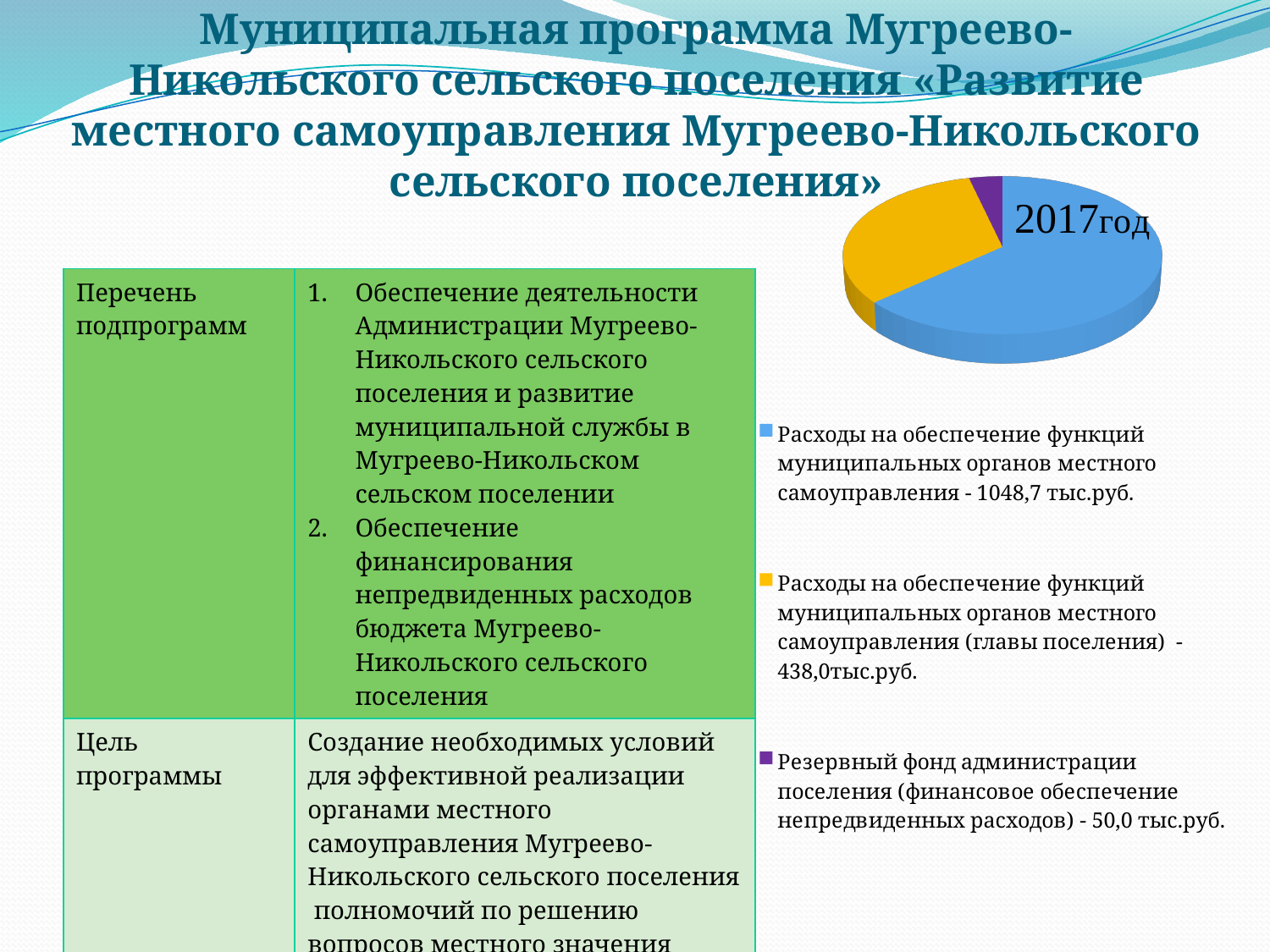
What is the value for «Резервный фонд администрации поселения (финансовое обеспечение непредвиденных расходов)» in the pie chart? 50,0 тыс.руб. What is the difference between the expenses for municipal bodies (1048,7) and the expenses for the head of the settlement (438,0) in the pie chart? 610,7 тыс.руб. How many slices does the pie chart have? 3 What is the value for «Расходы на обеспечение функций муниципальных органов местного самоуправления (главы поселения)» in the pie chart? 438,0 тыс.руб. Which category has the largest slice in the pie chart? Расходы на обеспечение функций муниципальных органов местного самоуправления What colour is the slice for the reserve fund (Резервный фонд администрации поселения) in the pie chart? purple What is the value for «Расходы на обеспечение функций муниципальных органов местного самоуправления» in the pie chart? 1048,7 тыс.руб. How many entries does the legend of the pie chart list? 3 What year is shown as the label of the pie chart? 2017год Which is larger in the pie chart: the expenses for the head of the settlement or the reserve fund? Расходы на обеспечение функций муниципальных органов местного самоуправления (главы поселения) What kind of chart is shown on the slide? pie chart Which category has the smallest slice in the pie chart? Резервный фонд администрации поселения (финансовое обеспечение непредвиденных расходов)